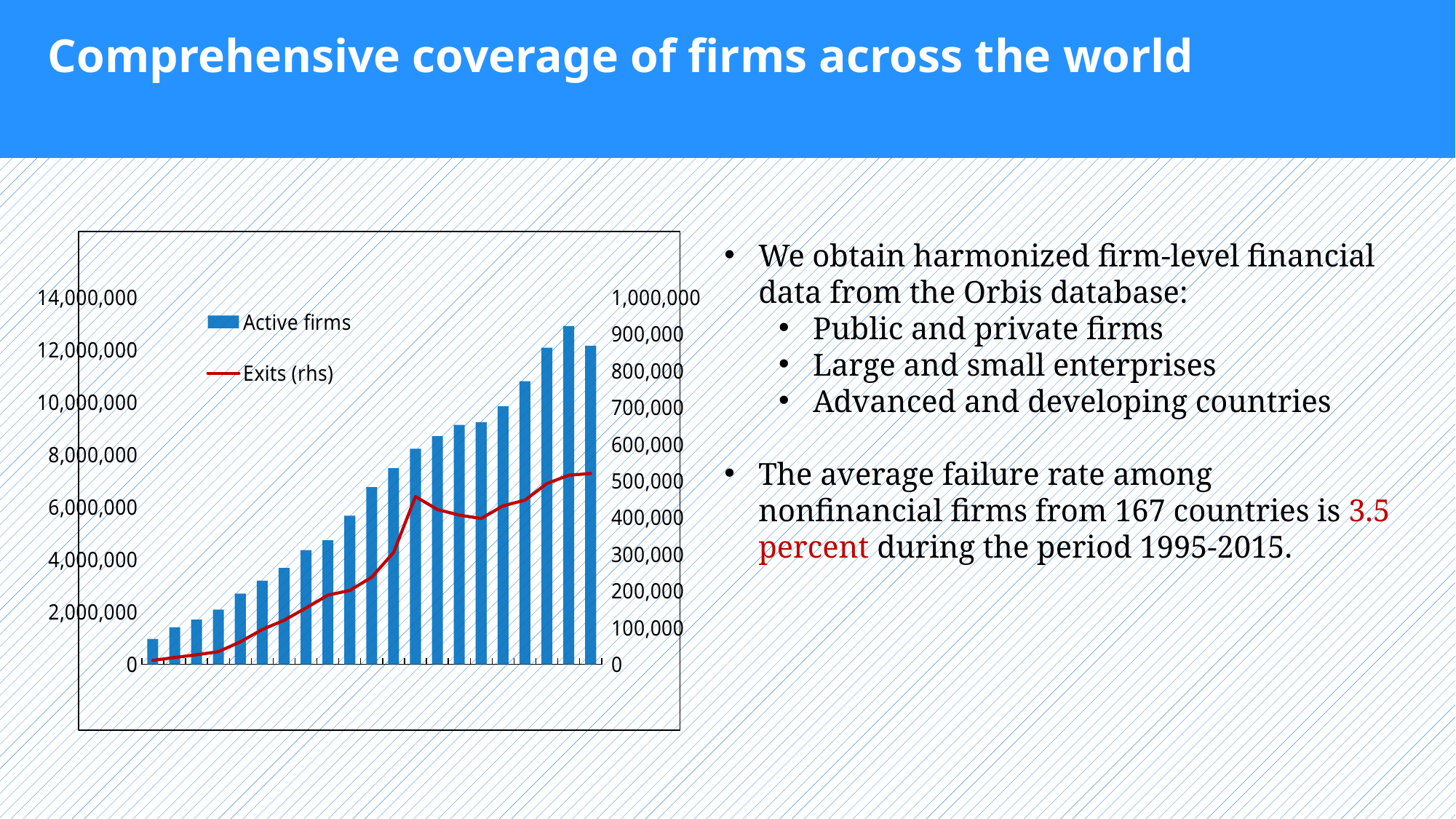
Is the value of the leftmost Active firms bar greater or less than 2,000,000? less Is the tallest Active firms bar the last bar in the chart? No, it is the second-to-last bar What kind of chart is shown on the slide? A combined bar and line chart Which is larger, the leftmost Active firms bar or the rightmost Active firms bar? The rightmost bar How many bars are plotted for the Active firms series? 21 Do the Active firms bars generally rise or fall from left to right? Rise What is the highest tick value shown on the right-hand axis of the chart? 1,000,000 Is the value of the rightmost Active firms bar greater or less than 10,000,000? greater Is the Exits line's first peak (around the middle of the chart) greater or less than 500,000 on the right-hand axis? less What are the two series named in the chart legend? Active firms and Exits (rhs) How many series does the chart legend list? 2